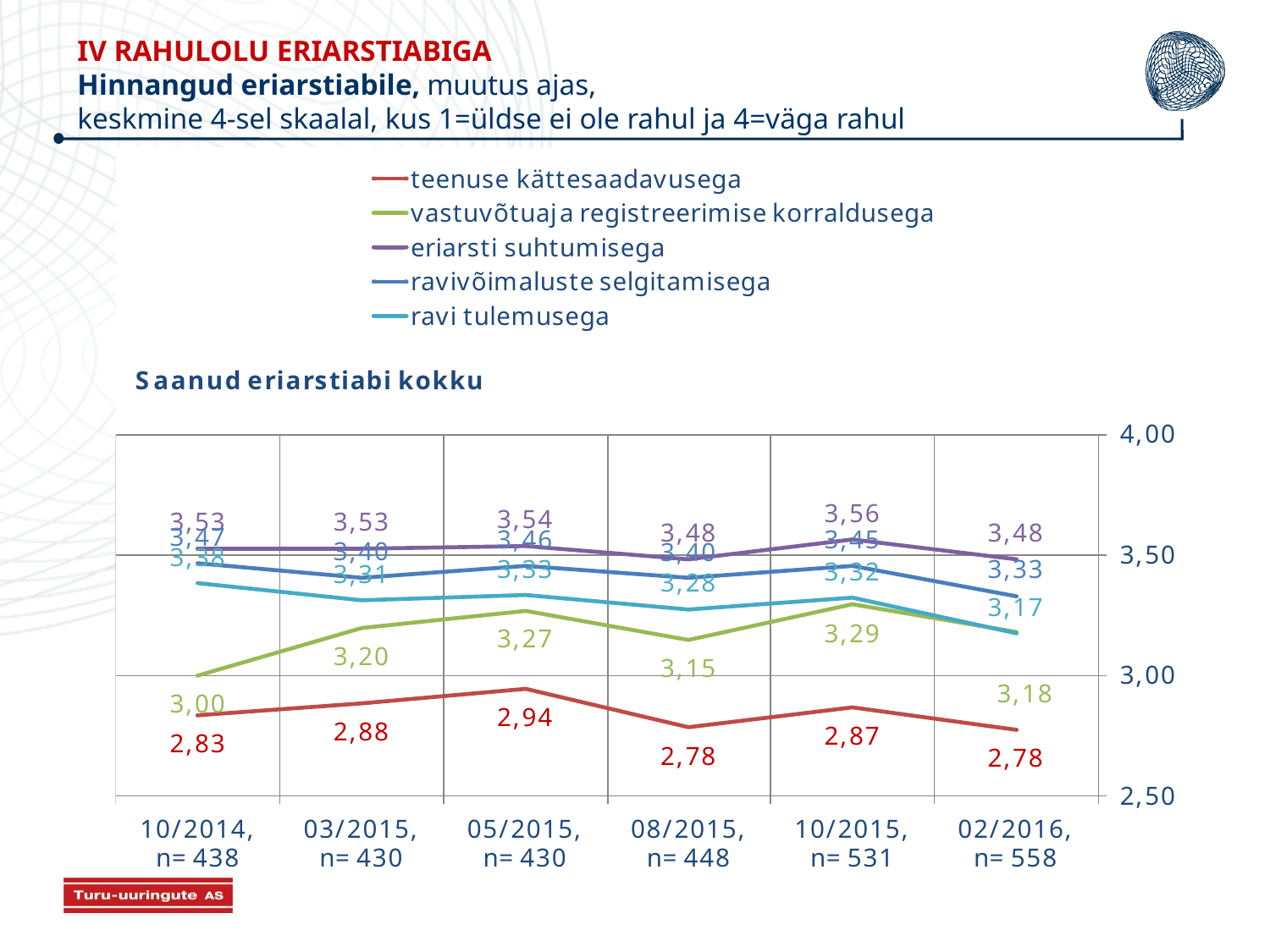
At which time point is 'vastuvõtuaja registreerimise korraldusega' lowest? 10/2014 How many series does the legend list? 5 At 02/2016, which is larger: 'ravivõimaluste selgitamisega' or 'ravi tulemusega'? ravivõimaluste selgitamisega What is the value for 'teenuse kättesaadavusega' at 05/2015? 2,94 Is the value for 'teenuse kättesaadavusega' at 10/2014 greater or less than 3,00? less How many time points are plotted along the x axis? 6 At which time point is 'teenuse kättesaadavusega' highest? 05/2015 What kind of chart is shown on the slide? line chart What is the value for 'vastuvõtuaja registreerimise korraldusega' at 08/2015? 3,15 What is the difference between the 'teenuse kättesaadavusega' values at 05/2015 and 08/2015? 0,16 What is the title of the chart? Saanud eriarstiabi kokku What is the value for 'eriarsti suhtumisega' at 10/2015? 3,56